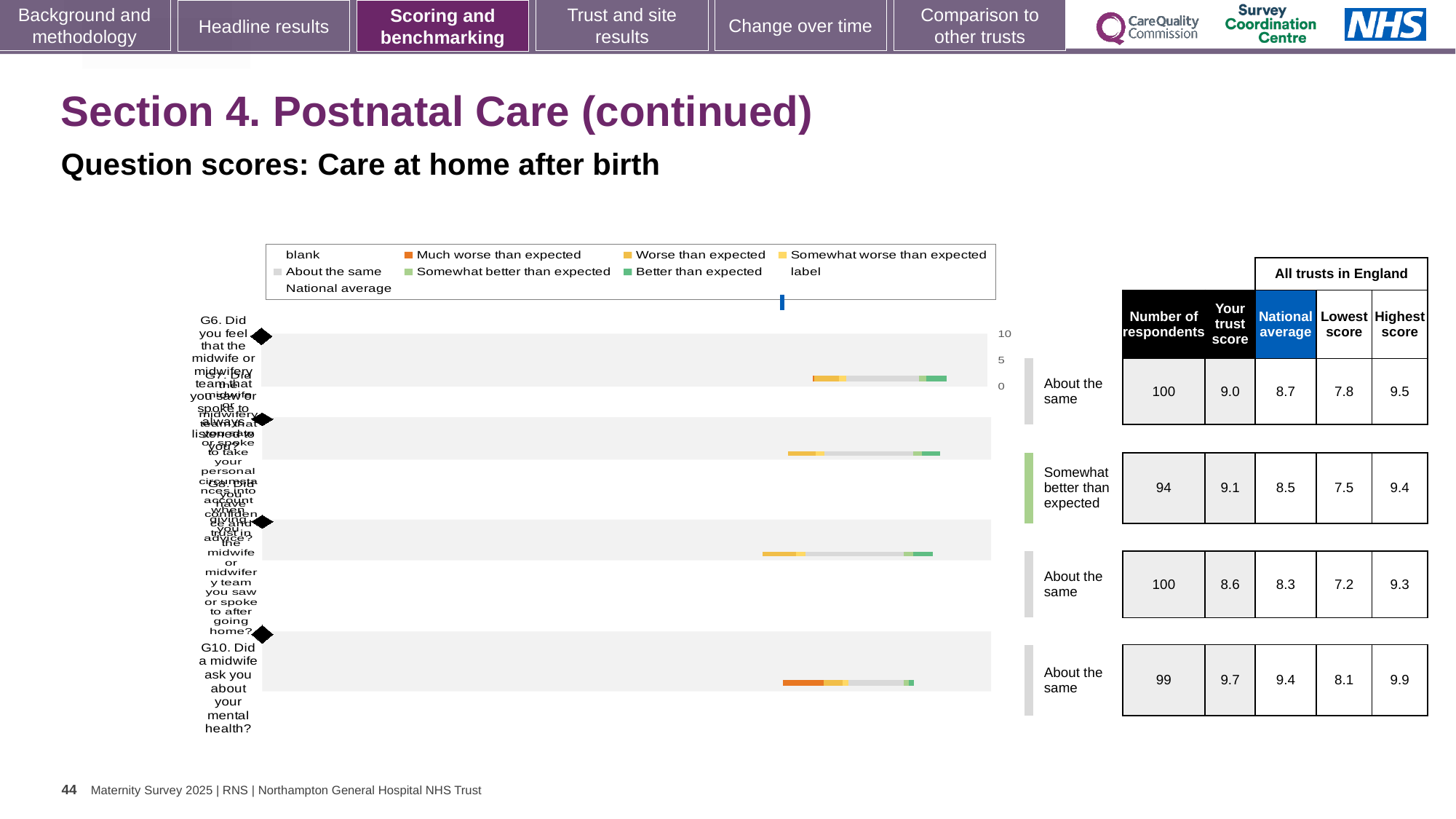
In the table beside the chart, which row has the highest 'Your trust score'? G10. Did a midwife ask you about your mental health? In the table beside the chart, what is the national average for G10 'Did a midwife ask you about your mental health?' 9.4 What is the title of the chart section on the slide? Question scores: Care at home after birth What kind of chart is shown on the slide? bar chart In the table beside the chart, what is the 'Your trust score' for G10 'Did a midwife ask you about your mental health?' 9.7 In the table beside the chart, which benchmark category is shown for the second row (trust score 9.1)? Somewhat better than expected In the table beside the chart, what is the 'Your trust score' for the first row (G6)? 9.0 In the table beside the chart, how many respondents are listed for G10 'Did a midwife ask you about your mental health?' 99 In the table beside the chart, what is the lowest number of respondents listed for any row? 94 In the table beside the chart, what is the difference between the trust score and the national average for G10 'Did a midwife ask you about your mental health?' 0.3 How many question rows (bars) does the chart show? 4 In the table beside the chart, what is the highest score across all trusts in England for G10 'Did a midwife ask you about your mental health?' 9.9